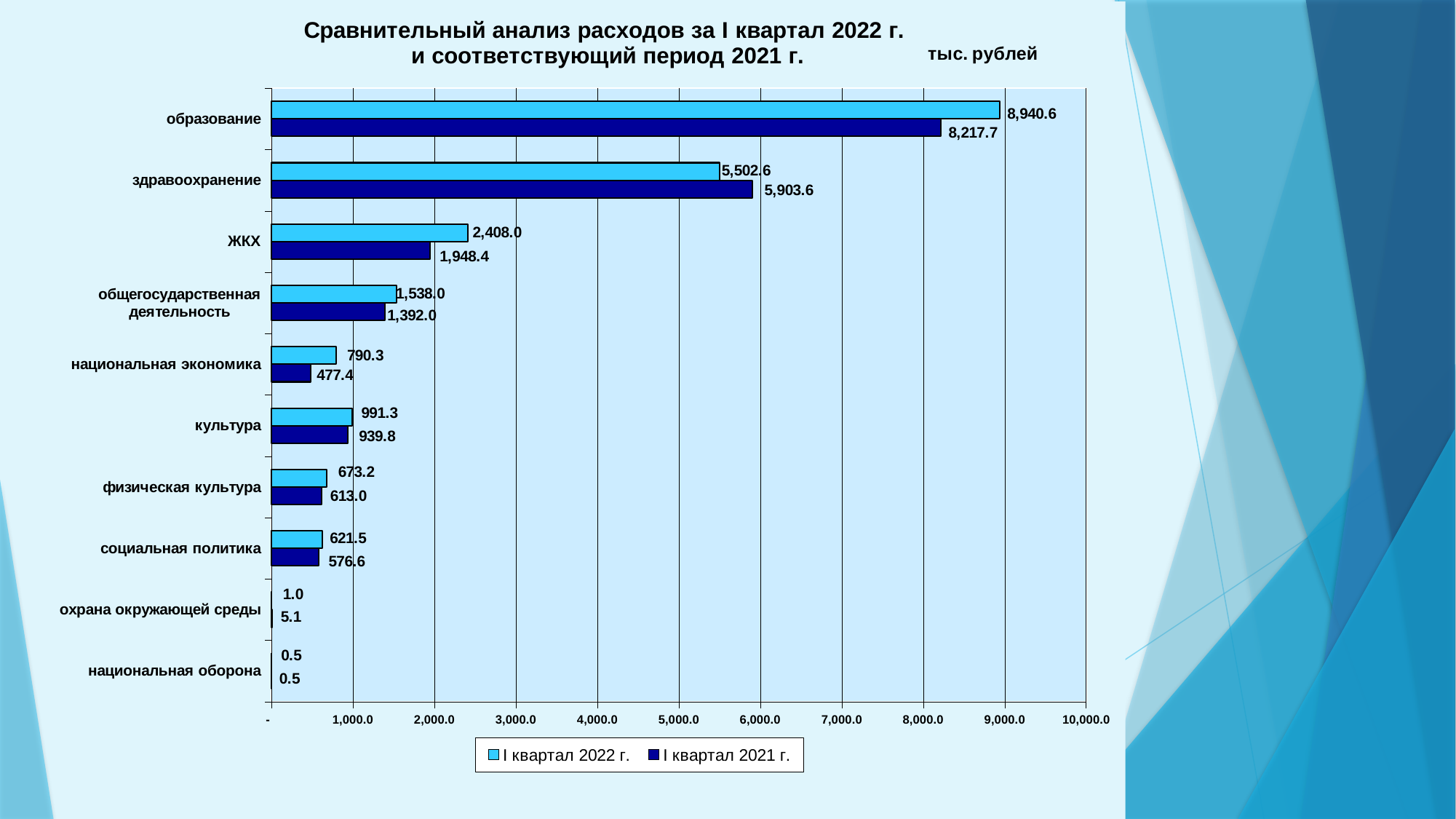
What is the difference between the I квартал 2022 г. and I квартал 2021 г. values for образование? 722.9 What is the difference between the I квартал 2021 г. and I квартал 2022 г. values for здравоохранение? 401.0 How many categories are shown on the chart? 10 Which category has the lowest value in I квартал 2021 г.? национальная оборона What is the value for национальная экономика in I квартал 2022 г.? 790.3 Which category has the highest value in I квартал 2022 г.? образование What unit is indicated next to the chart title? тыс. рублей What is the value for образование in I квартал 2022 г.? 8,940.6 How many series does the legend list? 2 What is the value for здравоохранение in I квартал 2021 г.? 5,903.6 For ЖКХ, which is larger: the I квартал 2022 г. value or the I квартал 2021 г. value? I квартал 2022 г. What type of chart is shown on the slide? bar chart